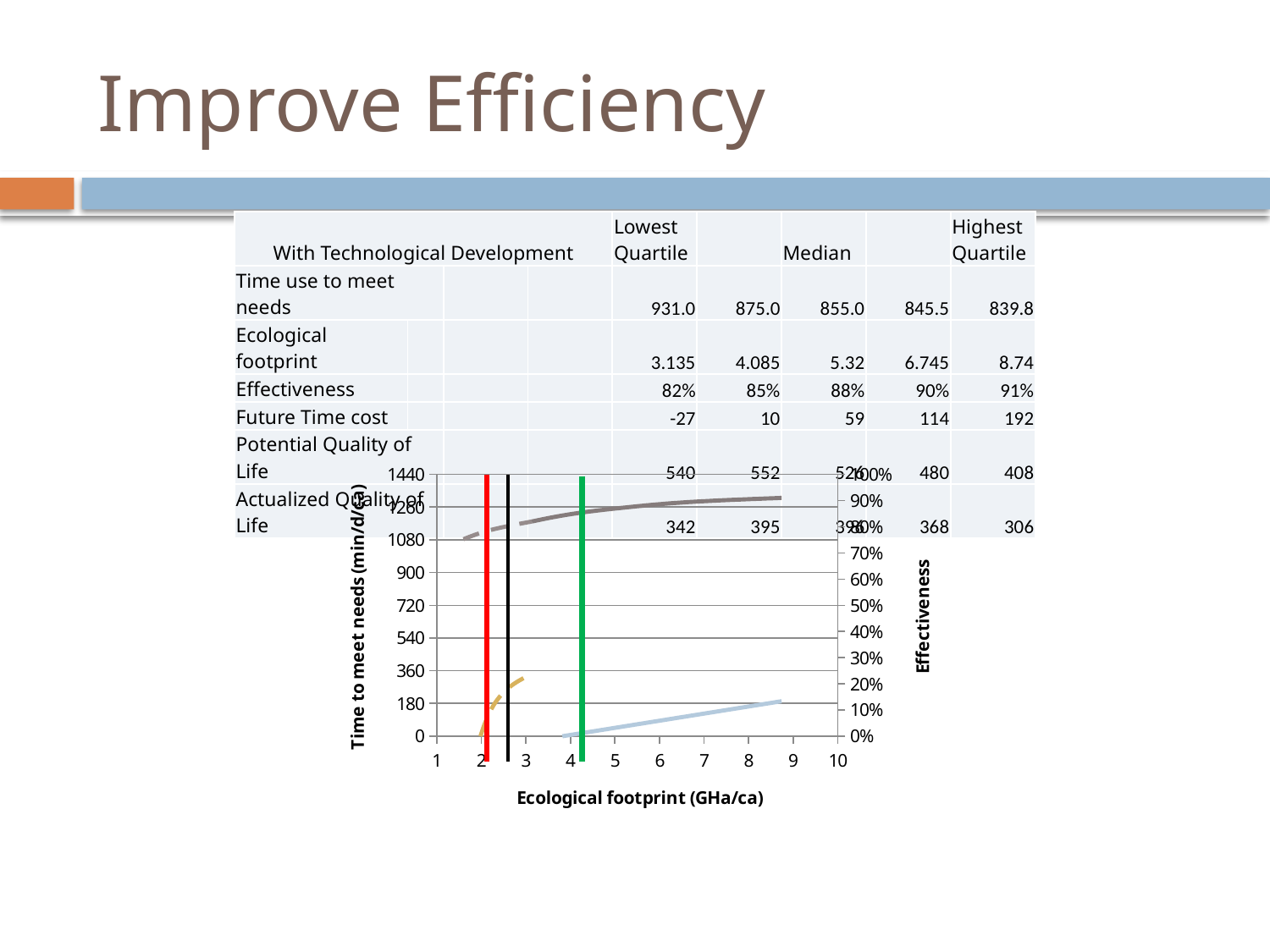
What is the title of the x axis of the chart? Ecological footprint (GHa/ca) On the left y axis, is the orange line at an ecological footprint of 3 greater or less than 540? less On the right y axis, is the grey curve at an ecological footprint of 8 greater or less than 70%? greater Does the grey curve rise or fall as the ecological footprint increases along the x axis? rise What is the title of the right-hand y axis of the chart? Effectiveness What kind of chart is shown on the slide? line chart How many tick labels are shown on the x axis of the chart? 10 On the left y axis, is the light blue line at an ecological footprint of 8 greater or less than 360? less Does the light blue line rise or fall as the ecological footprint increases along the x axis? rise Which is higher on the left y axis at an ecological footprint of 8: the grey curve or the light blue line? the grey curve